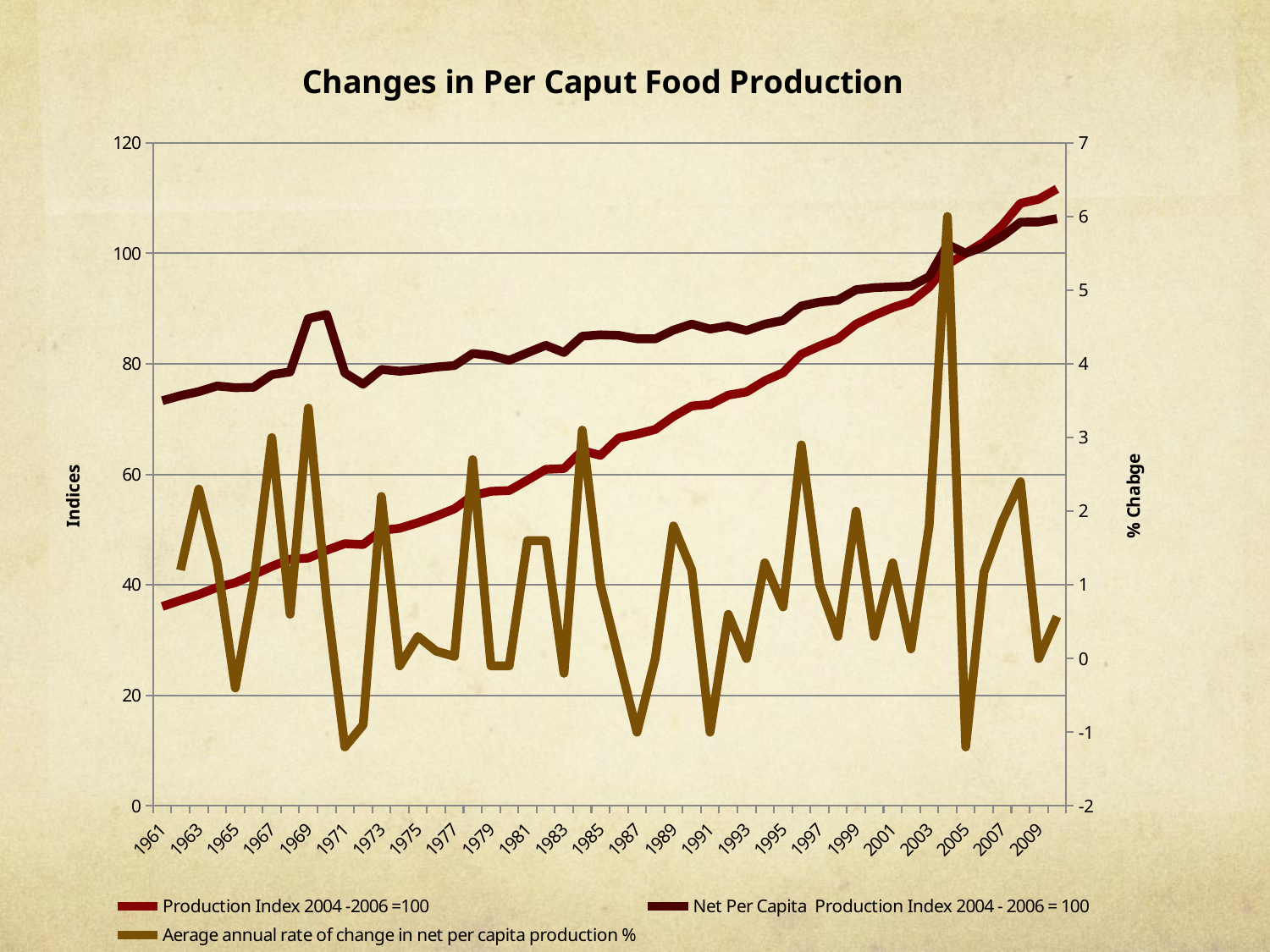
Is the average annual rate of change in net per capita production in 2005 greater or less than 0 on the right axis? less What kind of chart is shown on the slide? Line chart Is the value of the Production Index 2004-2006=100 in 2009 greater or less than 100? greater In which year does the average annual rate of change in net per capita production reach its highest value? 2004 What is the label on the left vertical axis? Indices How many series does the legend list? 3 Does the Production Index 2004-2006=100 series rise or fall from 1961 to 2009? Rise Is the value of the Production Index 2004-2006=100 in 1961 greater or less than 40? less What is the title of the chart? Changes in Per Caput Food Production In 1961, which is higher: the Production Index 2004-2006=100 or the Net Per Capita Production Index 2004-2006=100? Net Per Capita Production Index 2004-2006=100